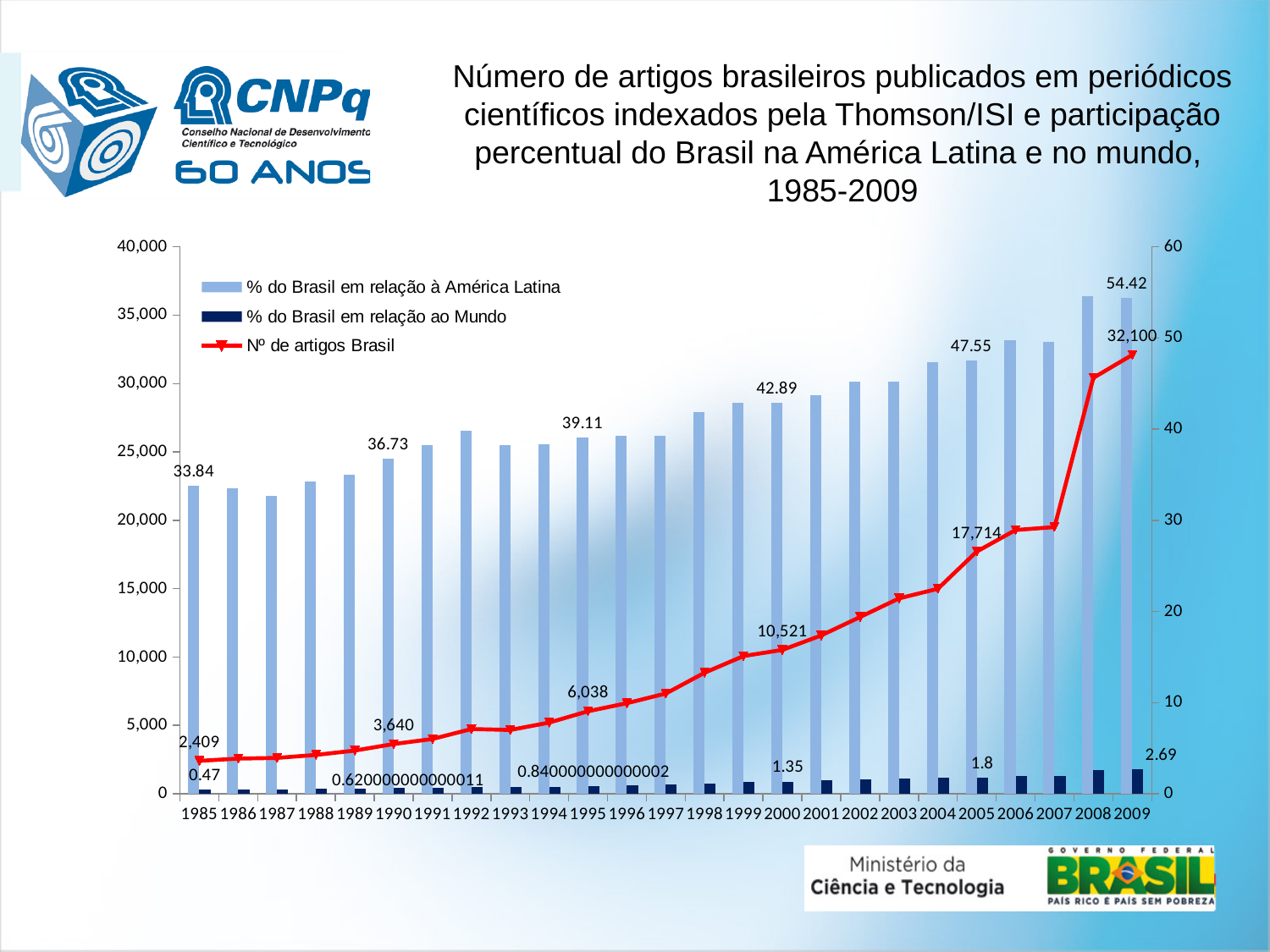
What is the difference between Nº de artigos Brasil in 2009 and in 2005? 14,386 Which year has the larger Nº de artigos Brasil, 1990 or 1995? 1995 Does Nº de artigos Brasil rise or fall from 1985 to 2009? Rises What is the value of % do Brasil em relação à América Latina in 2009? 54.42 What is the value of % do Brasil em relação à América Latina in 1985? 33.84 What is the value of % do Brasil em relação ao Mundo in 2005? 1.8 What is the difference between % do Brasil em relação à América Latina in 2009 and in 1985? 20.58 How many series does the legend list? 3 How many years are shown on the x axis? 25 What kind of chart is this? Combination bar and line chart What is the value of Nº de artigos Brasil in 2000? 10,521 What is the value of Nº de artigos Brasil in 2009? 32,100